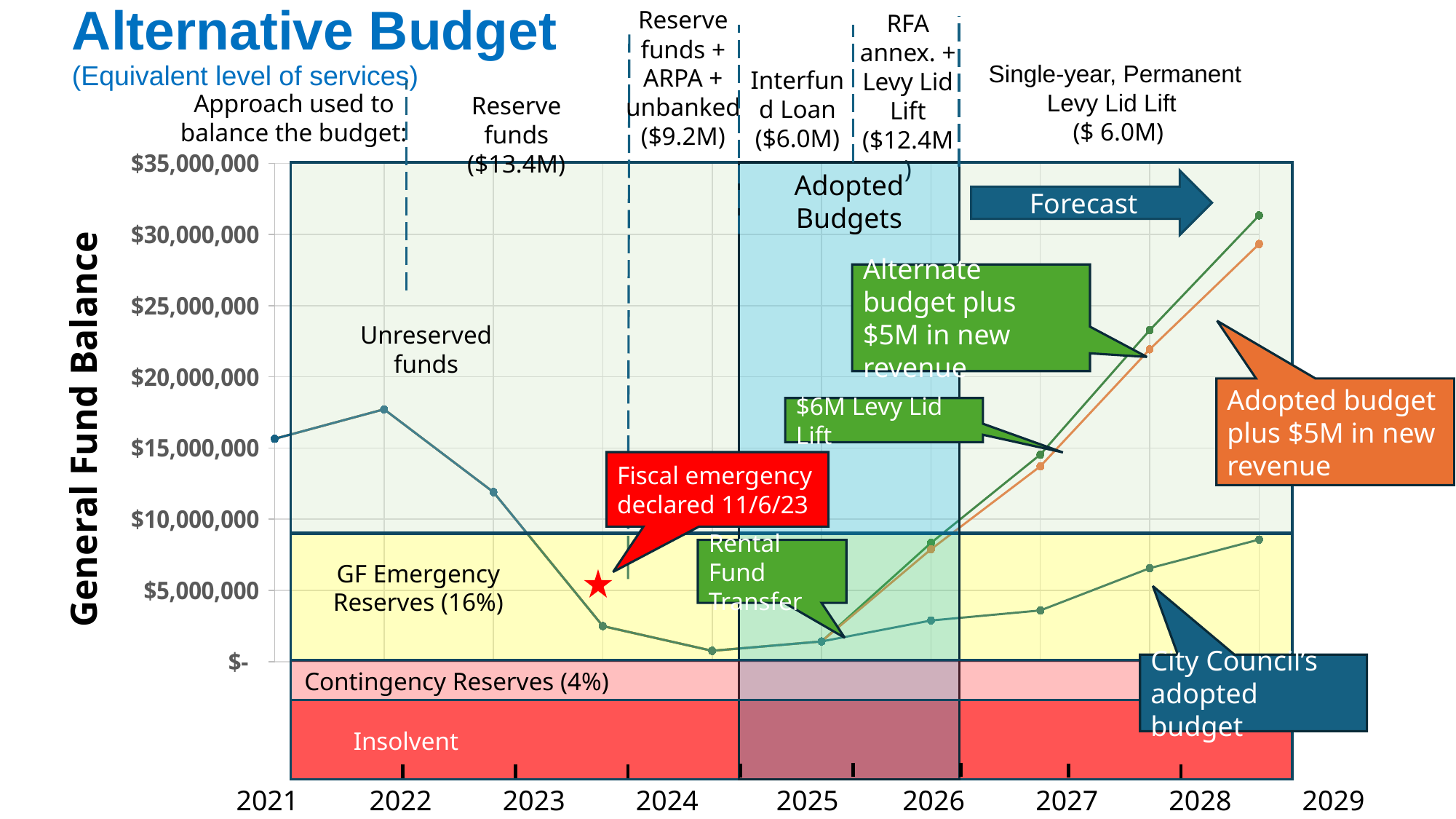
Does City Council's adopted budget rise or fall between 2022 and 2024? fall In 2028, which is lower: City Council's adopted budget or the adopted budget plus $5M in new revenue? City Council's adopted budget What is the title of the vertical axis of the chart? General Fund Balance On what date does the chart say the fiscal emergency was declared? 11/6/23 How many lines (series) are plotted on the chart? 3 Is the value of City Council's adopted budget in 2024 greater or less than $5,000,000? less Is the value of the adopted budget plus $5M in new revenue in 2027 greater or less than $20,000,000? less What kind of chart is shown on the slide? line chart Does the alternate budget plus $5M in new revenue rise or fall between 2025 and 2028? rise In 2028, which is higher: the alternate budget plus $5M in new revenue or the adopted budget plus $5M in new revenue? Alternate budget plus $5M in new revenue